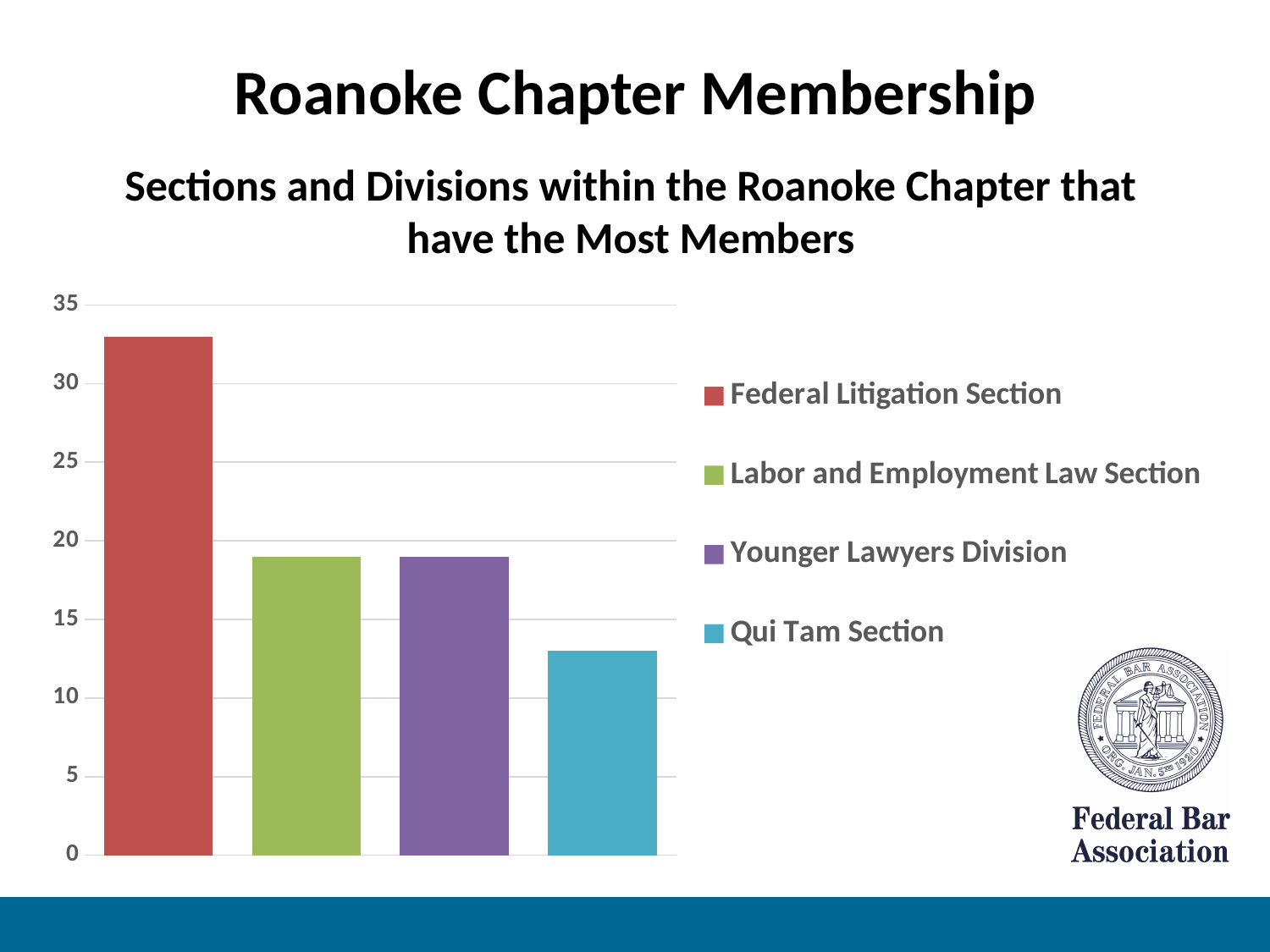
Is the value for the Qui Tam Section greater or less than 15? less Is the value for the Labor and Employment Law Section greater or less than 20? less Which section or division has the highest membership in the chart? Federal Litigation Section What colour is the bar for the Qui Tam Section? blue Is the value for the Federal Litigation Section greater or less than 30? greater How many entries does the chart legend list? 4 Which section or division has the lowest membership in the chart? Qui Tam Section What kind of chart is shown on the slide? bar chart Which has more members, the Federal Litigation Section or the Younger Lawyers Division? Federal Litigation Section Which has more members, the Labor and Employment Law Section or the Qui Tam Section? Labor and Employment Law Section